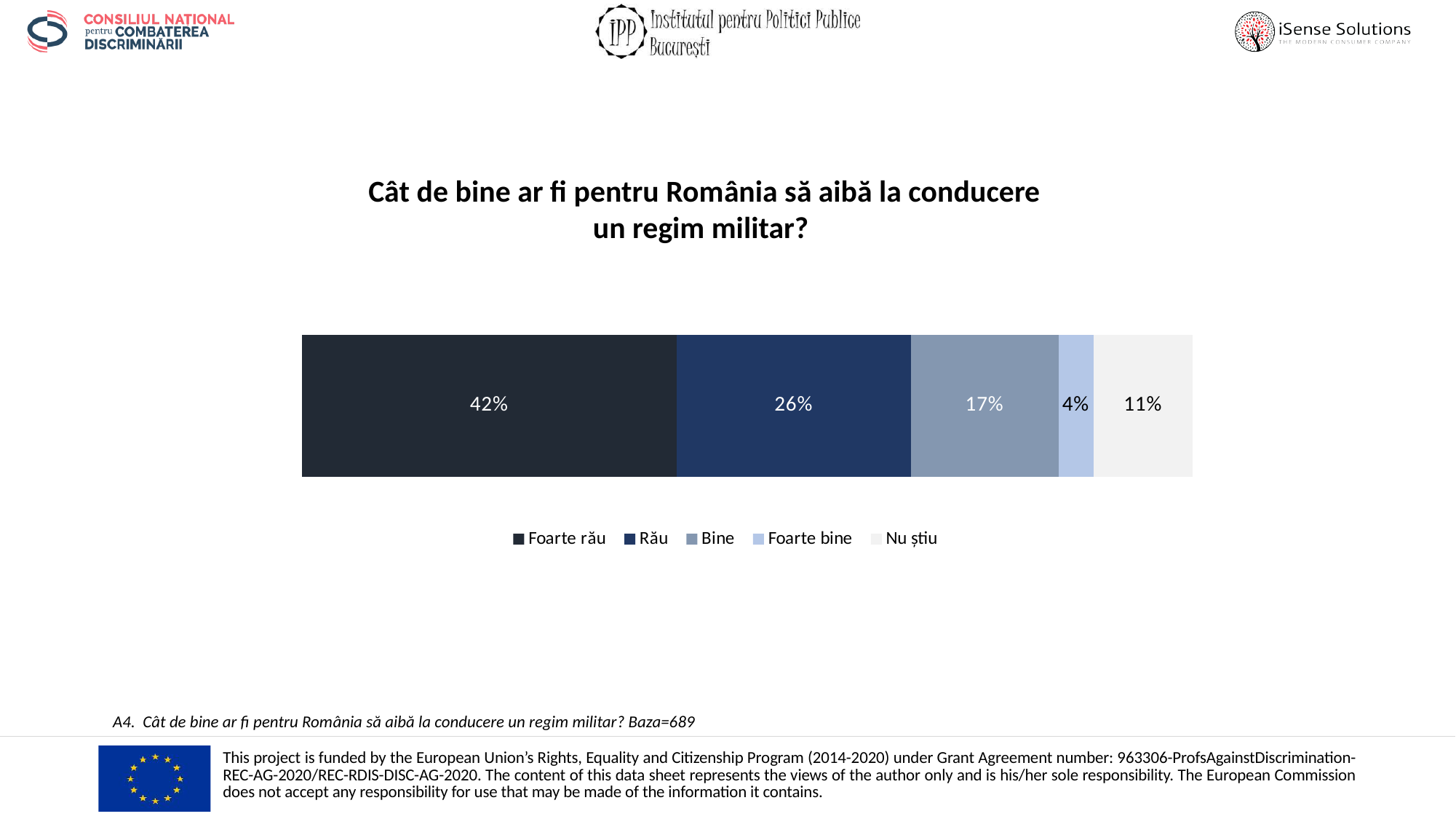
What percentage of respondents answered "Rău"? 26% What kind of chart is shown on the slide? Stacked bar chart Which response category has the smallest share? Foarte bine What is the difference between the "Foarte rău" and "Rău" shares? 16 percentage points What percentage of respondents answered "Bine"? 17% What is the combined share of "Foarte rău" and "Rău"? 68% What percentage of respondents answered "Foarte rău"? 42% Which response category has the largest share? Foarte rău Which is larger, the share for "Bine" or the share for "Nu știu"? Bine What percentage of respondents answered "Nu știu"? 11% What percentage of respondents answered "Foarte bine"? 4% How many series does the legend list? 5